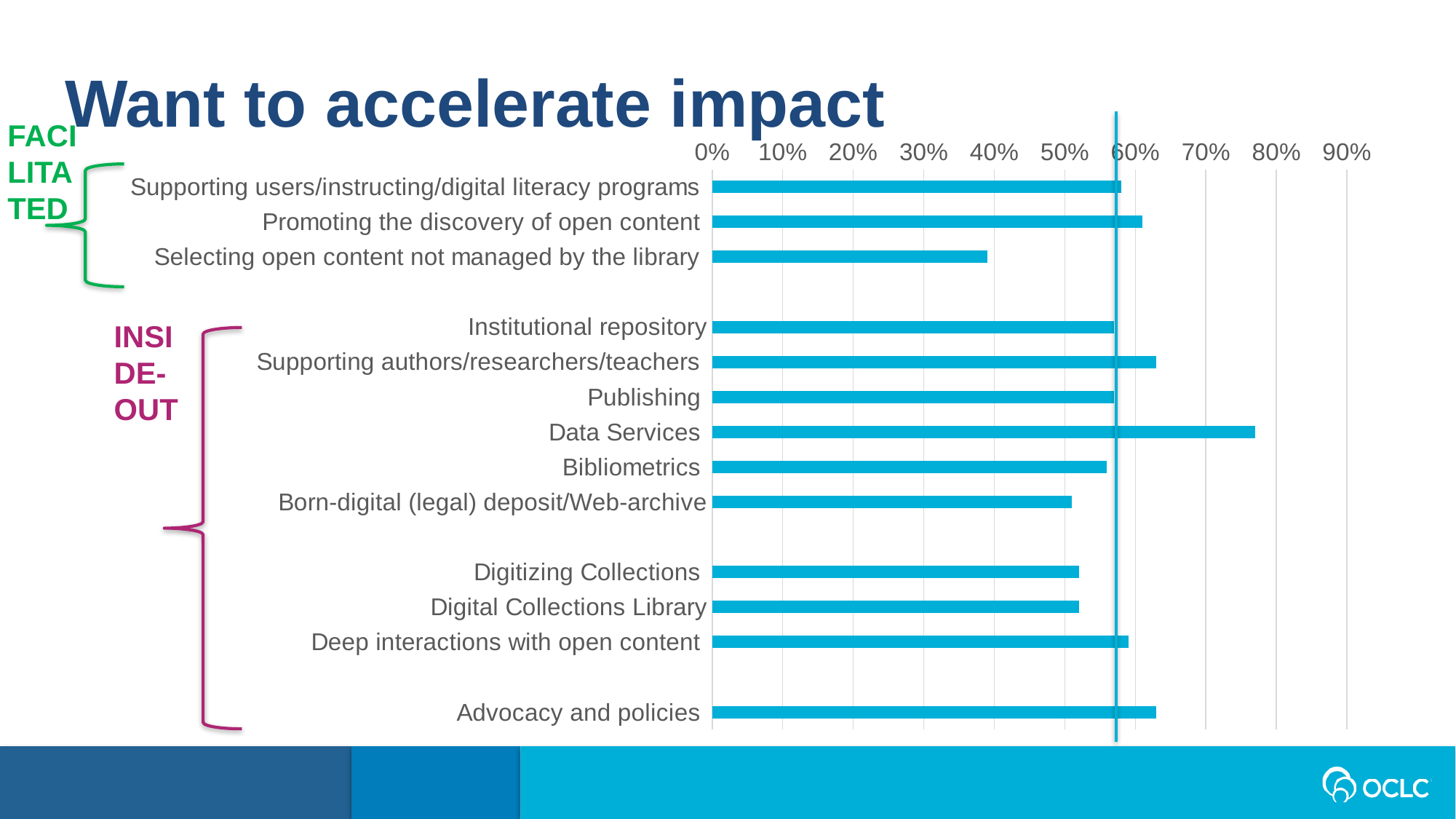
Which two group labels are written beside the brackets to the left of the category names? FACILITATED and INSIDE-OUT Which is larger, the value for Institutional repository or the value for Selecting open content not managed by the library? Institutional repository Which is larger, the value for Data Services or the value for Bibliometrics? Data Services How many categories (bars) are plotted in the chart? 13 What is the title of the slide containing the chart? Want to accelerate impact Is the value for Bibliometrics greater or less than 50%? greater Is the value for Advocacy and policies greater or less than 60%? greater Which category has the highest value in the chart? Data Services What kind of chart is shown on the slide? bar chart Which category has the lowest value in the chart? Selecting open content not managed by the library Is the value for Data Services greater or less than 70%? greater